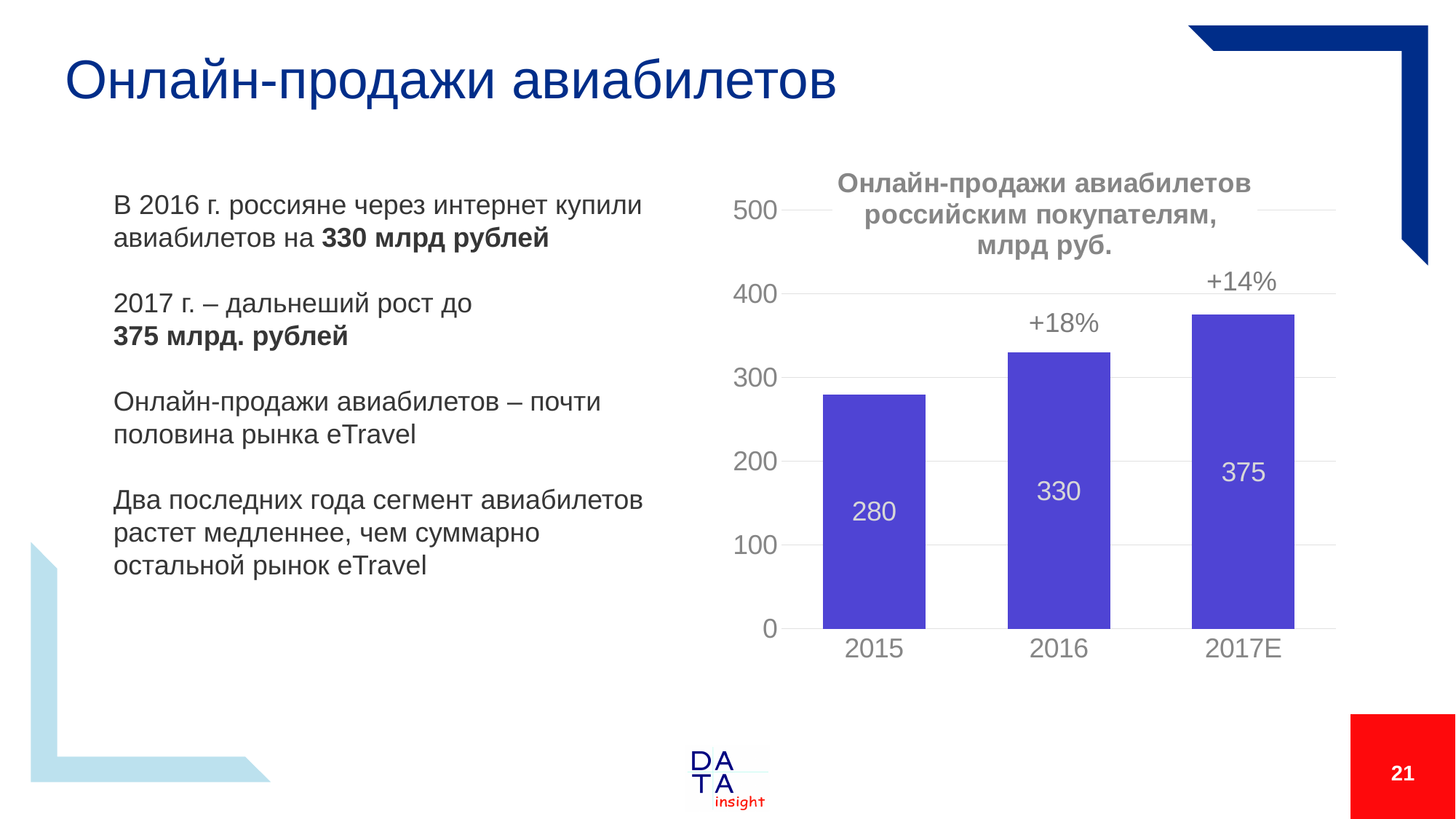
Which is larger, the value for 2015 or the value for 2016? 2016 What is the difference between the values for 2017E and 2016? 45 Which year has the lowest value in the chart? 2015 How many bars are shown in the chart? 3 Which year has the highest value in the chart? 2017E What kind of chart is shown on the slide? bar chart What growth percentage is labelled above the 2016 bar? +18% What is the value for 2015 in the chart? 280 Is the value for 2017E greater or less than 400? less What is the value for 2016 in the chart? 330 What is the difference between the values for 2016 and 2015? 50 What is the value for 2017E in the chart? 375